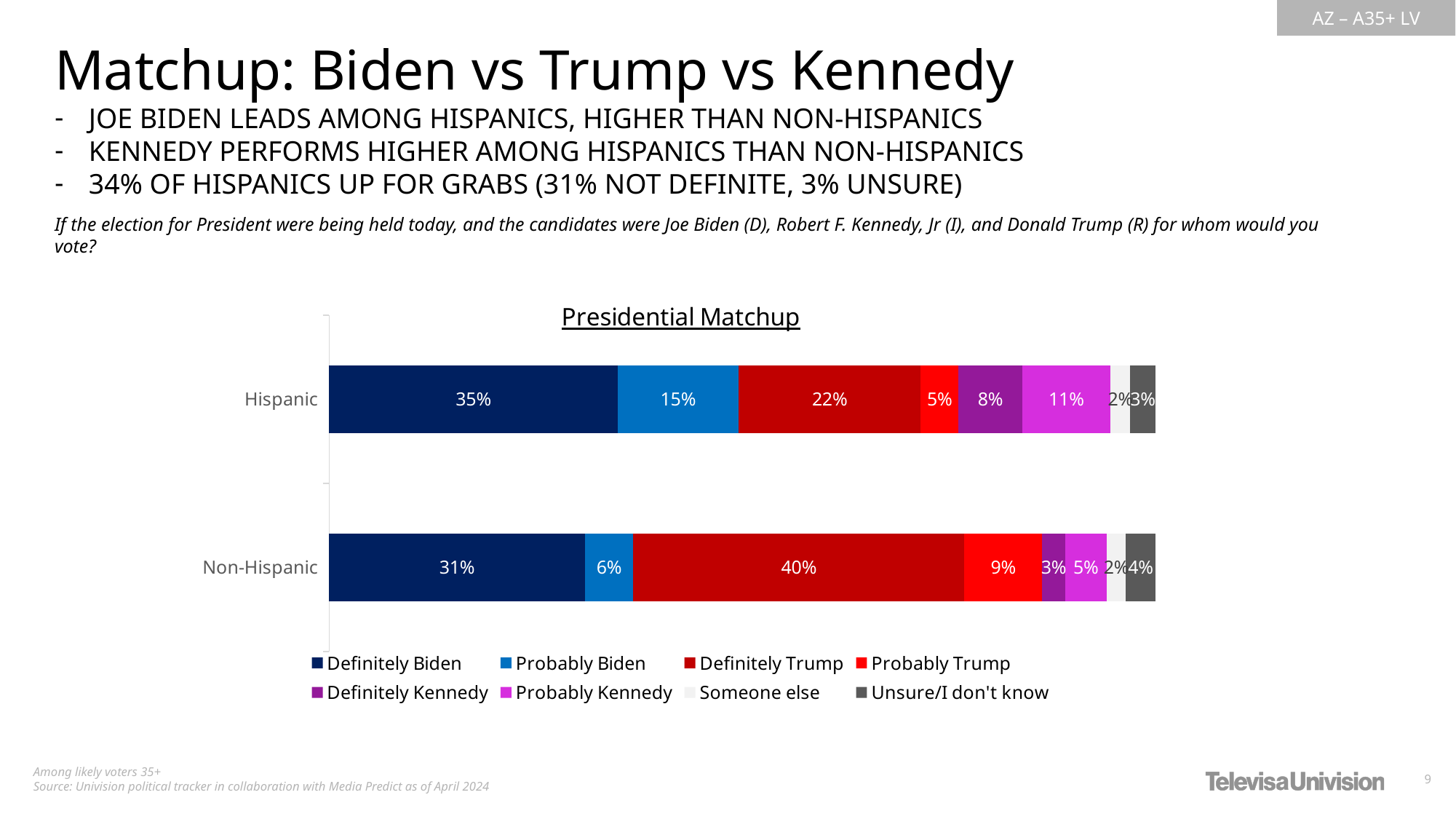
What is the difference between the Definitely Trump values for Non-Hispanic and Hispanic voters? 18% What kind of chart is the Presidential Matchup chart? Stacked bar chart What is the Unsure/I don't know value for Non-Hispanic voters? 4% What is the Definitely Biden value for Hispanic voters? 35% Which is larger: Probably Biden for Hispanic voters or Probably Biden for Non-Hispanic voters? Hispanic How many categories are shown on the Presidential Matchup chart? 2 Which segment is the smallest in the Hispanic bar? Someone else Which segment is the largest in the Non-Hispanic bar? Definitely Trump How many series does the legend of the Presidential Matchup chart list? 8 What is the Definitely Trump value for Non-Hispanic voters? 40% What is the Probably Kennedy value for Hispanic voters? 11% What colour represents Definitely Kennedy in the legend? Purple